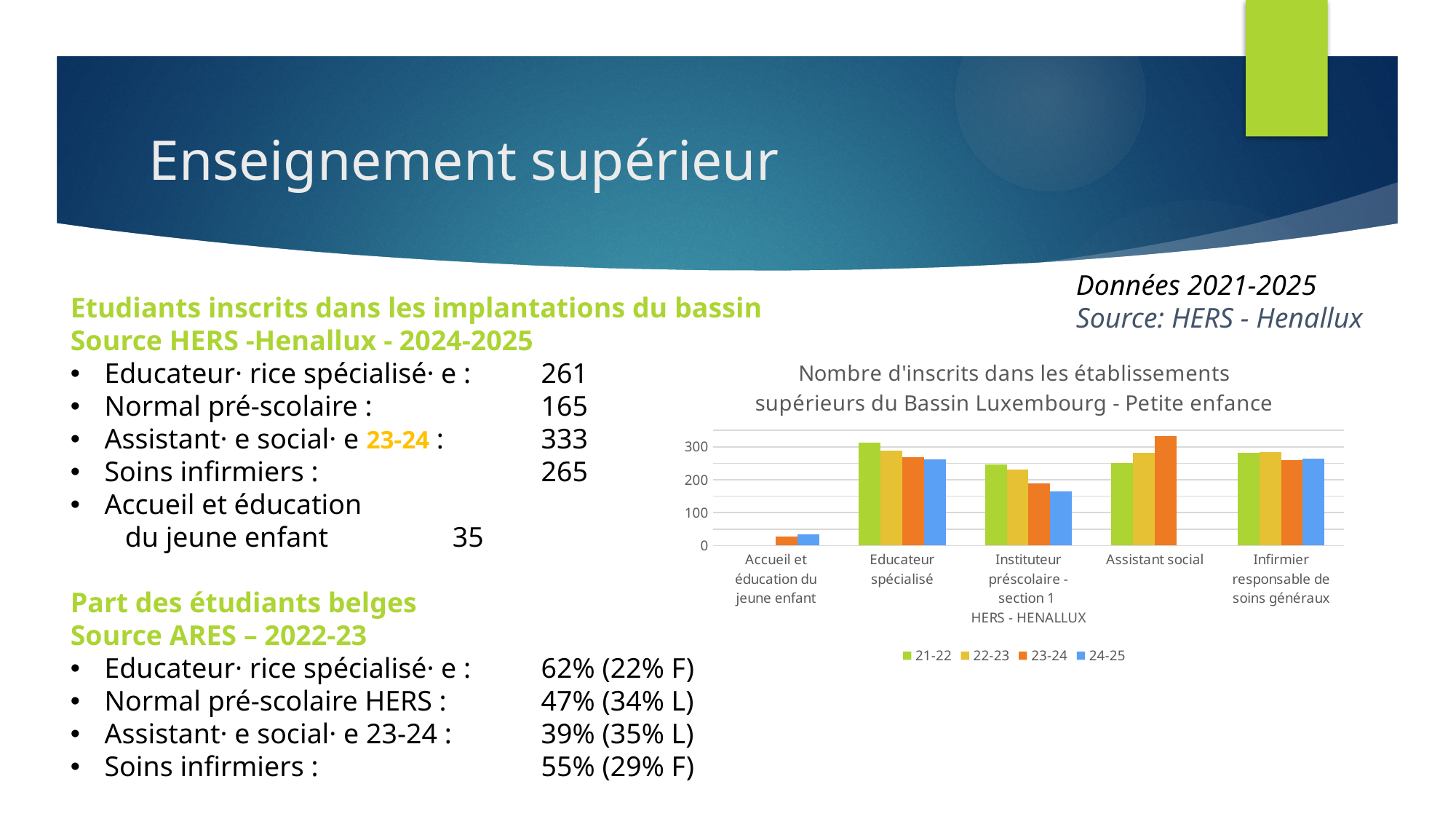
Is the 23-24 value for Accueil et éducation du jeune enfant greater or less than 100? less Is the 24-25 value for Instituteur préscolaire - section 1 greater or less than 200? less For Instituteur préscolaire - section 1, which is larger: the 21-22 value or the 24-25 value? 21-22 What is the title of the chart? Nombre d'inscrits dans les établissements supérieurs du Bassin Luxembourg - Petite enfance Which series is shown in green in the chart legend? 21-22 What kind of chart is shown on the slide? bar chart Is the 21-22 value for Educateur spécialisé greater or less than 300? greater How many categories are shown on the x axis of the chart? 5 Which category has the lowest bars in the chart? Accueil et éducation du jeune enfant How many series does the chart legend list? 4 Which category has the tallest bar in the chart? Assistant social Do the values for Instituteur préscolaire - section 1 rise or fall from 21-22 to 24-25? fall